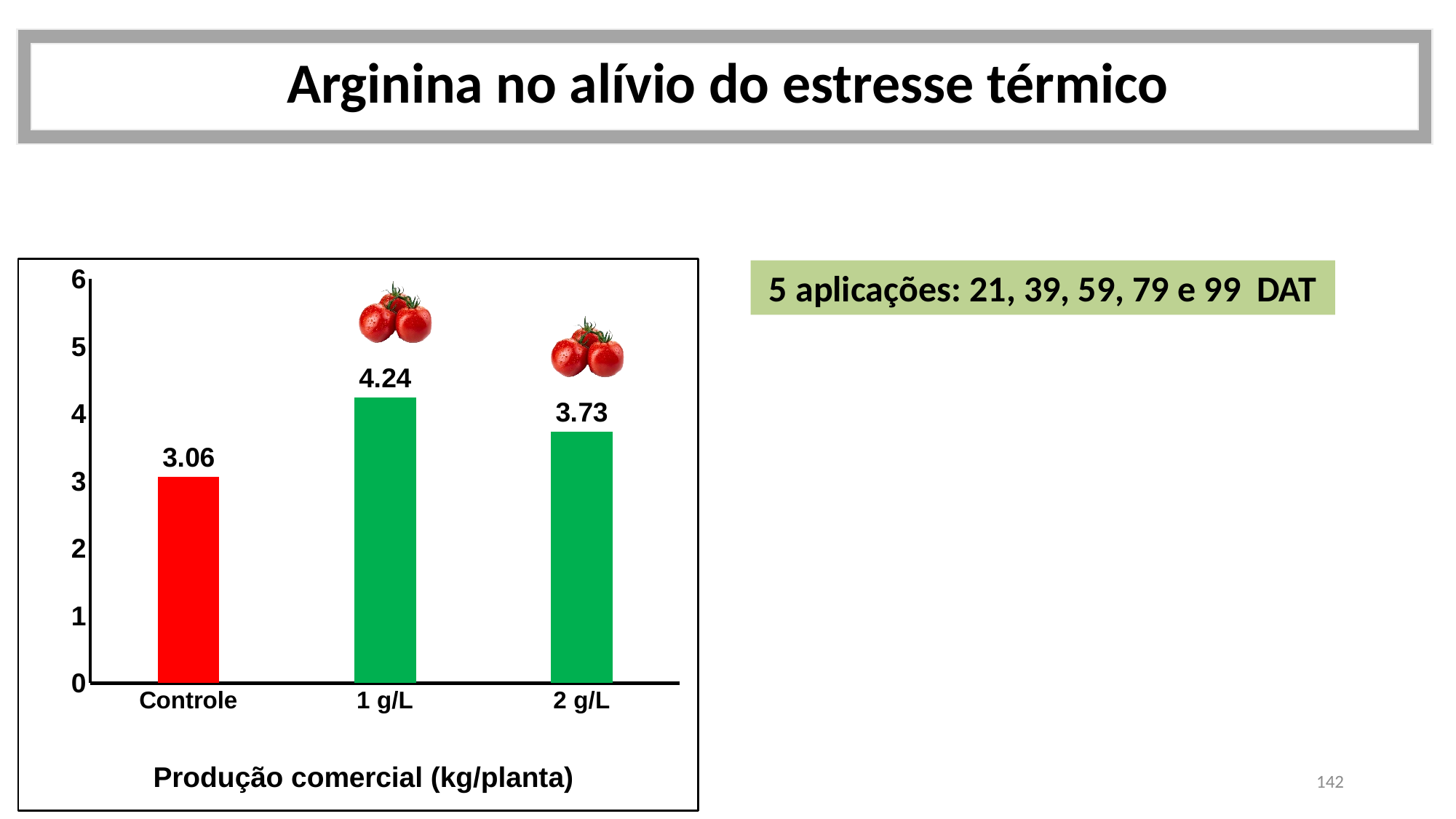
What is the value for Controle? 3.06 Which is larger, the value for 2 g/L or the value for Controle? 2 g/L What is the value for 1 g/L? 4.24 What kind of chart is shown on the slide? bar chart Which category has the highest value? 1 g/L How many categories are shown on the chart? 3 What is the label below the x axis of the chart? Produção comercial (kg/planta) Is the value for 1 g/L greater or less than 4? greater Which category has the lowest value? Controle What is the difference between the values for 1 g/L and 2 g/L? 0.51 What is the difference between the values for 1 g/L and Controle? 1.18 What is the value for 2 g/L? 3.73